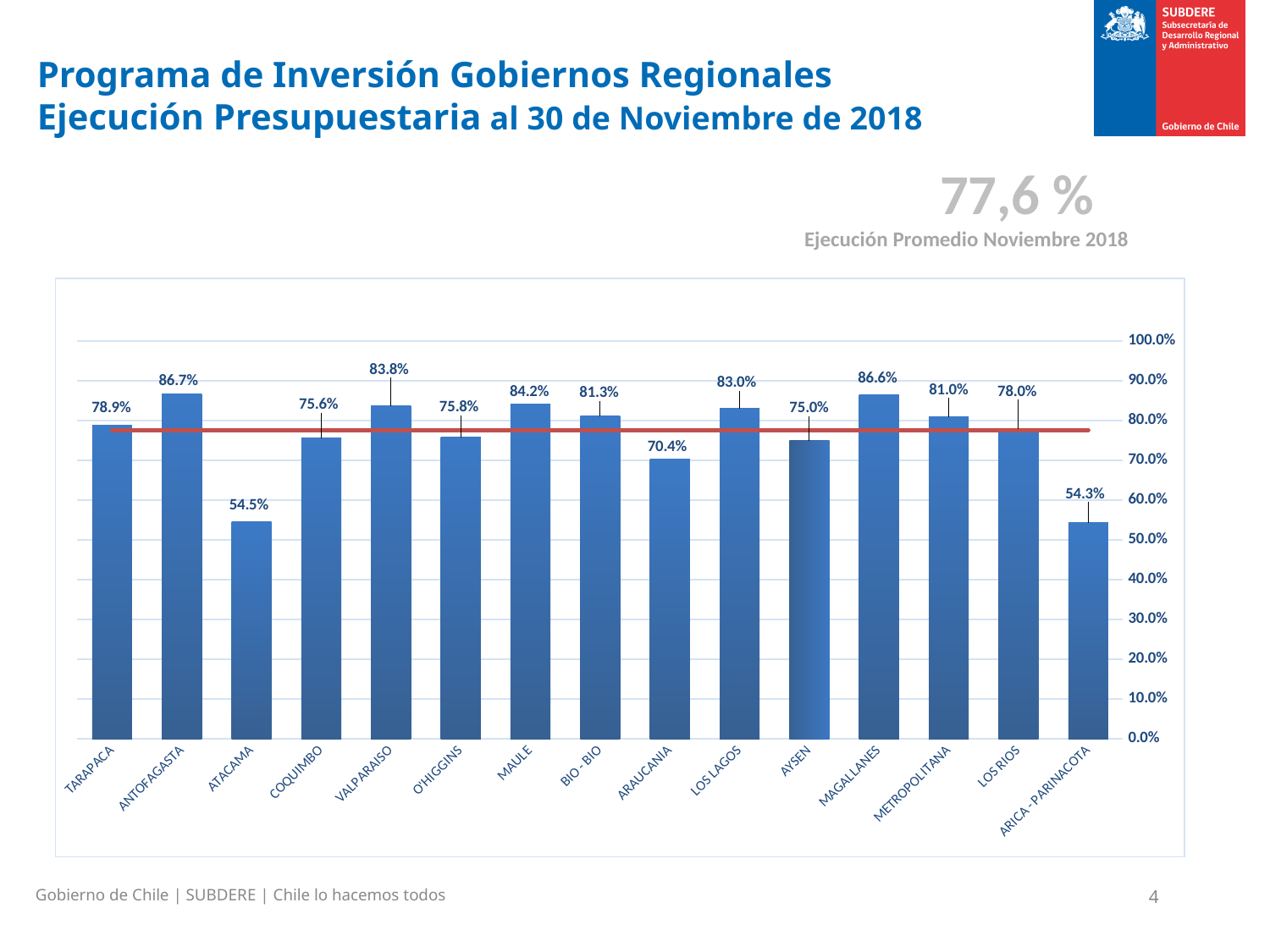
What average execution value is shown above the chart for November 2018? 77,6 % Is the value for ATACAMA greater or less than 60.0%? less How many regions are shown on the x axis of the chart? 15 What kind of chart is shown on the slide? bar chart What is the difference between the values for ANTOFAGASTA and ATACAMA? 32.2% What is the value for LOS RIOS? 78.0% What is the value for AYSEN? 75.0% What is the difference between the values for MAULE and ARAUCANIA? 13.8% What is the value for ARAUCANIA? 70.4% Which is larger, the value for LOS LAGOS or the value for COQUIMBO? LOS LAGOS What is the value for VALPARAISO? 83.8% Which is larger, the value for ARICA - PARINACOTA or the value for METROPOLITANA? METROPOLITANA